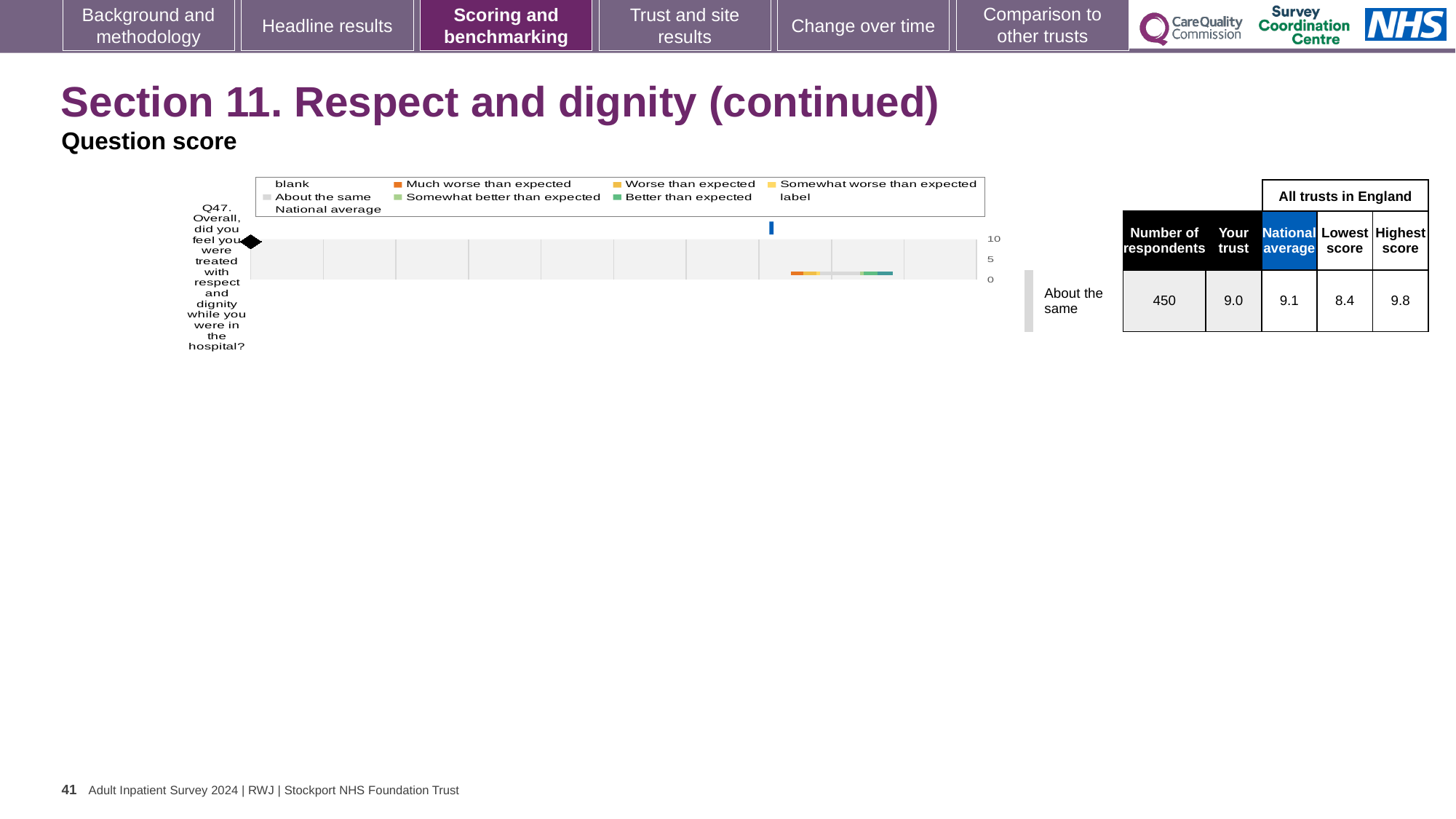
What benchmarking category is the trust's Q47 result labelled as? About the same What is the lowest score among all trusts in England for Q47? 8.4 What is the difference between the highest score (9.8) and the lowest score (8.4) for Q47? 1.4 What is the 'Your trust' score for Q47 (treated with respect and dignity)? 9.0 What is the highest tick value shown on the chart's axis? 10 Which is larger for Q47, the 'Your trust' score or the national average? National average Is the 'Your trust' score for Q47 greater or less than 5 on the chart's axis? greater How many respondents answered Q47? 450 What is the highest score among all trusts in England for Q47? 9.8 What is the difference between the national average (9.1) and the 'Your trust' score (9.0) for Q47? 0.1 How many questions are plotted on the chart? 1 What is the national average score for Q47 (treated with respect and dignity)? 9.1